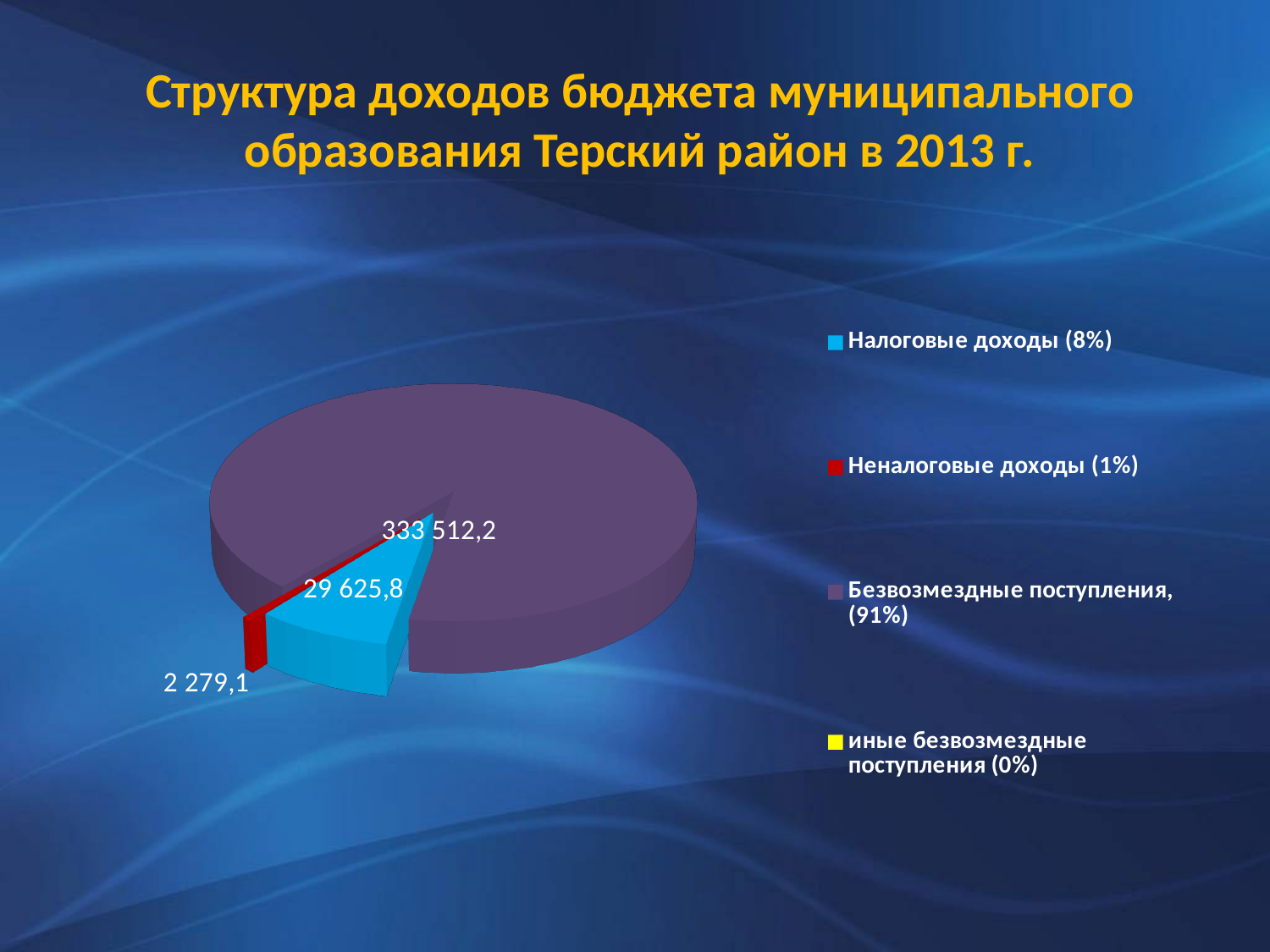
Which category has the smallest share according to the legend? иные безвозмездные поступления What share of the pie do Безвозмездные поступления make up, according to the legend? 91% Which is larger, the value for Налоговые доходы or the value for Неналоговые доходы? Налоговые доходы What is the value shown for Безвозмездные поступления? 333 512,2 What colour is the slice for Неналоговые доходы? Red What share of the pie do Налоговые доходы make up, according to the legend? 8% What is the value shown for Налоговые доходы? 29 625,8 What is the difference between the values for Безвозмездные поступления and Налоговые доходы? 303 886,4 What kind of chart is shown on the slide? Pie chart How many categories does the legend of the pie chart list? 4 Which category has the largest slice of the pie? Безвозмездные поступления What is the value shown for Неналоговые доходы? 2 279,1